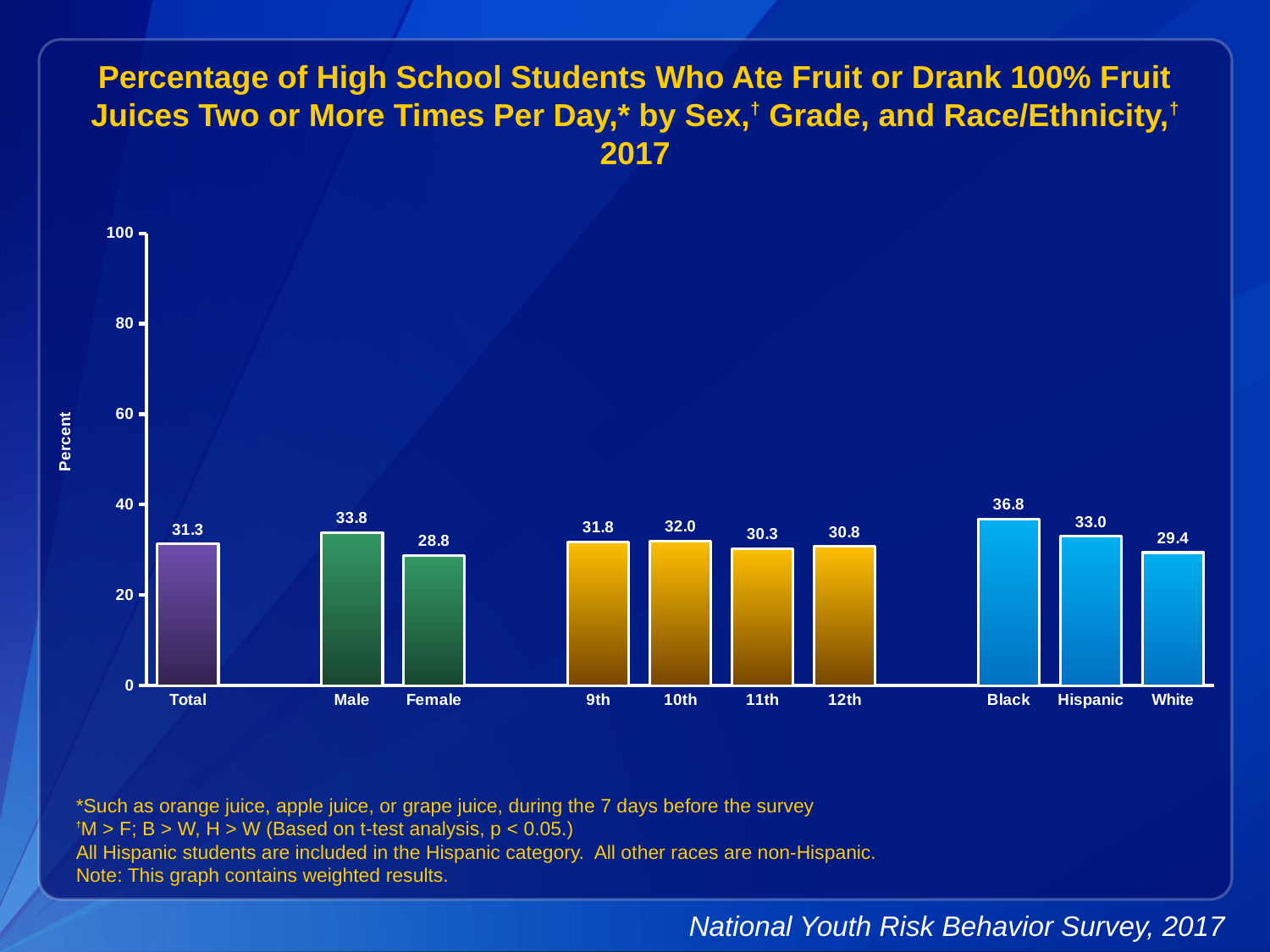
What is the difference between the values for Male and Female? 5.0 Which is larger, the value for 10th grade or 12th grade? 10th Which category has the highest value? Black What is the value for Total? 31.3 What is the difference between the values for Black and White? 7.4 What is the value for 11th grade? 30.3 Is the value for 9th grade greater or less than 40? less How many bars are shown in the chart? 10 What is the value for Hispanic? 33.0 What kind of chart is this? bar chart What is the value for Female? 28.8 Which category has the lowest value? Female